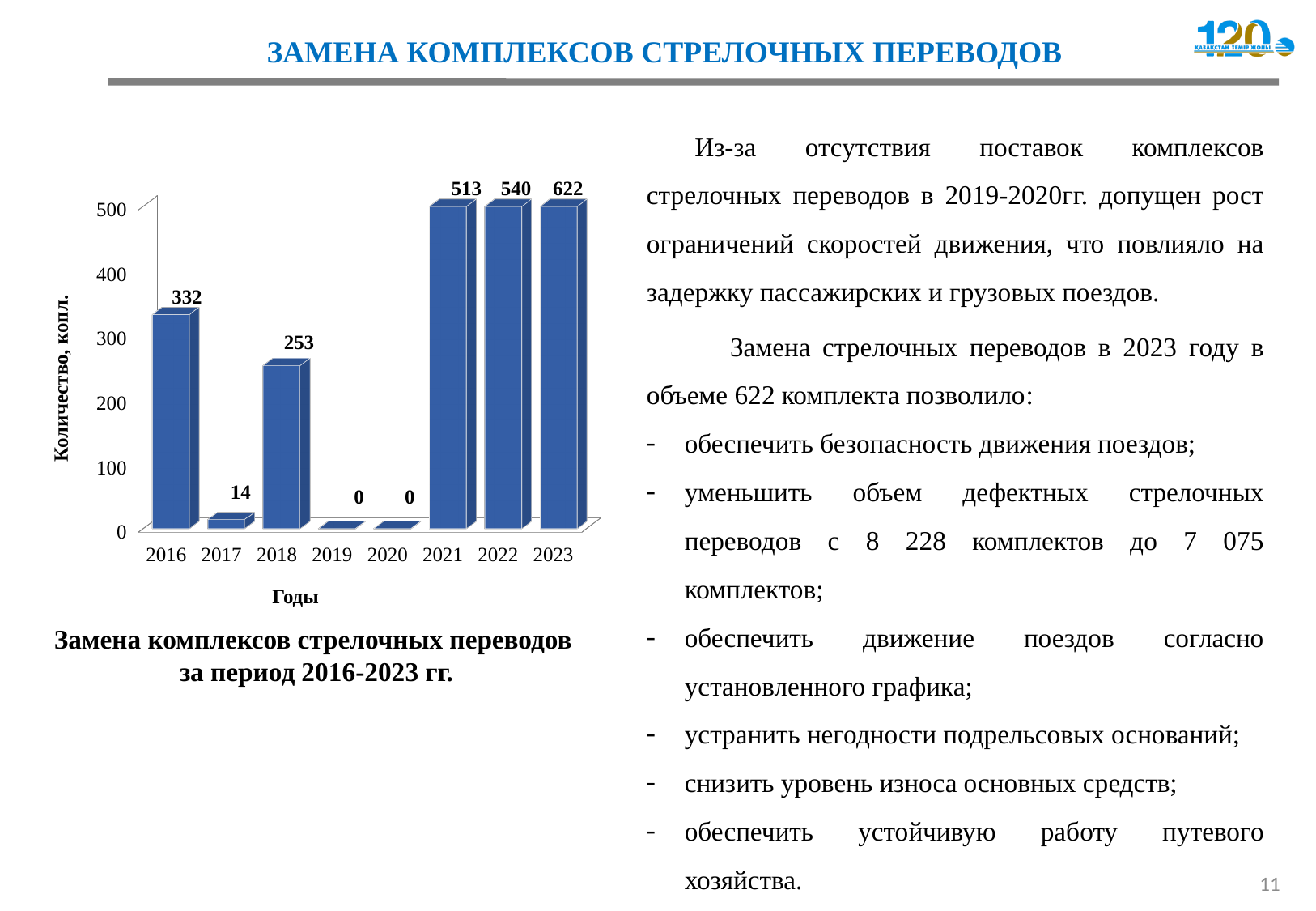
Which year has the highest value? 2023 Which is larger, the value for 2021 or the value for 2016? 2021 What is the value for 2016? 332 How many years are shown on the x axis? 8 What is the label of the x axis? Годы What is the value for 2018? 253 What is the difference between the values for 2023 and 2022? 82 What is the value for 2017? 14 What kind of chart is this? bar chart What is the difference between the values for 2016 and 2018? 79 What is the value for 2023? 622 Do the values rise or fall from 2021 to 2023? rise